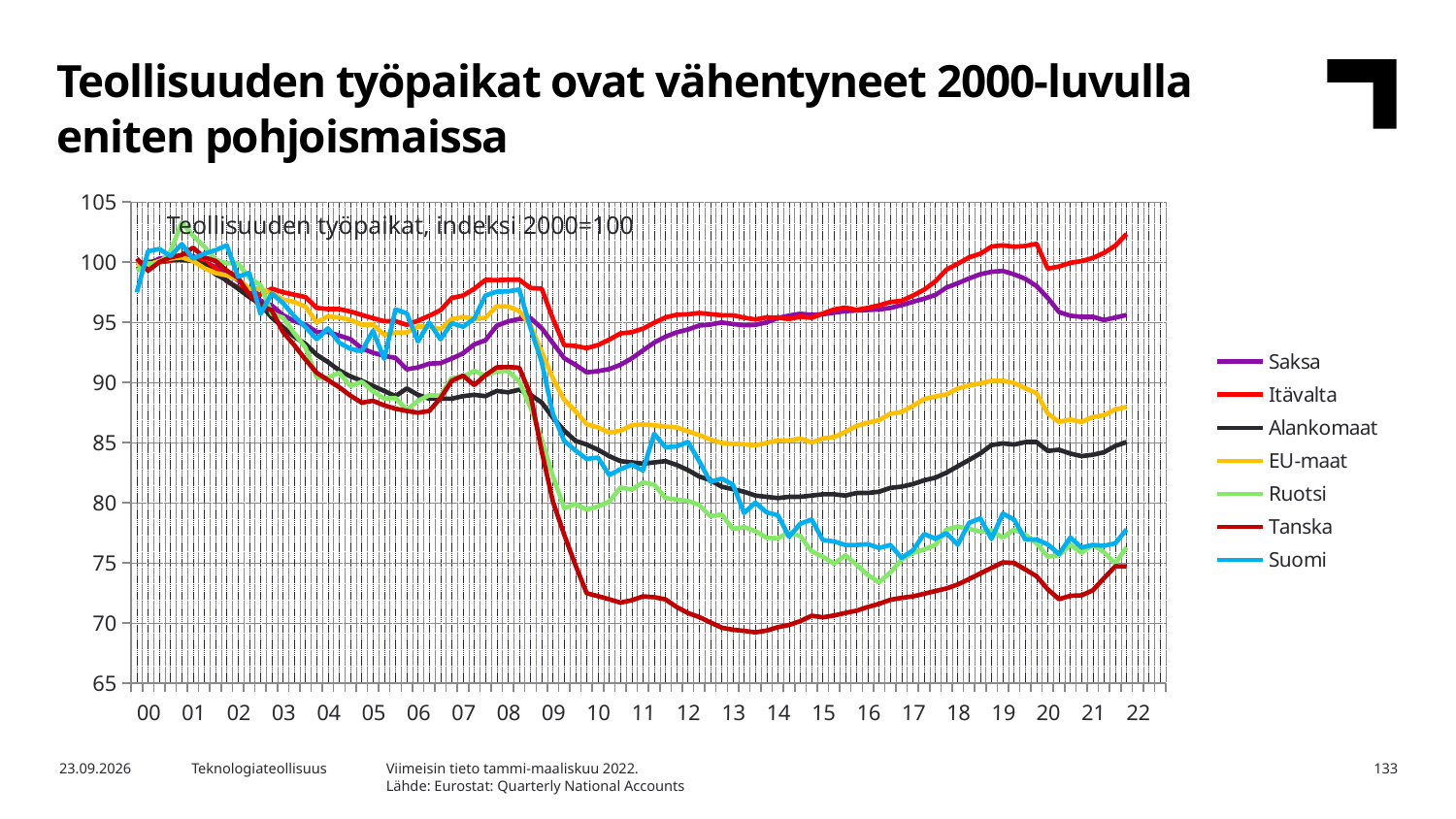
In 2018, which is larger: the value for EU-maat or the value for Ruotsi? EU-maat Which series has the lowest value around 2014? Tanska Which series is drawn in purple? Saksa What kind of chart is shown on the slide? line chart What is the title printed inside the chart area? Teollisuuden työpaikat, indeksi 2000=100 Is the value for Alankomaat in 2014 greater or less than 85? less How many series does the legend list? 7 Does the Tanska line rise or fall between 2000 and 2014? fall Is the value for Tanska in 2016 greater or less than 75? less In 2019, which is larger: the value for Saksa or the value for Alankomaat? Saksa Is the value for Itävalta at the end of the chart (22) greater or less than 100? greater Which series has the highest value at the end of the chart (22)? Itävalta